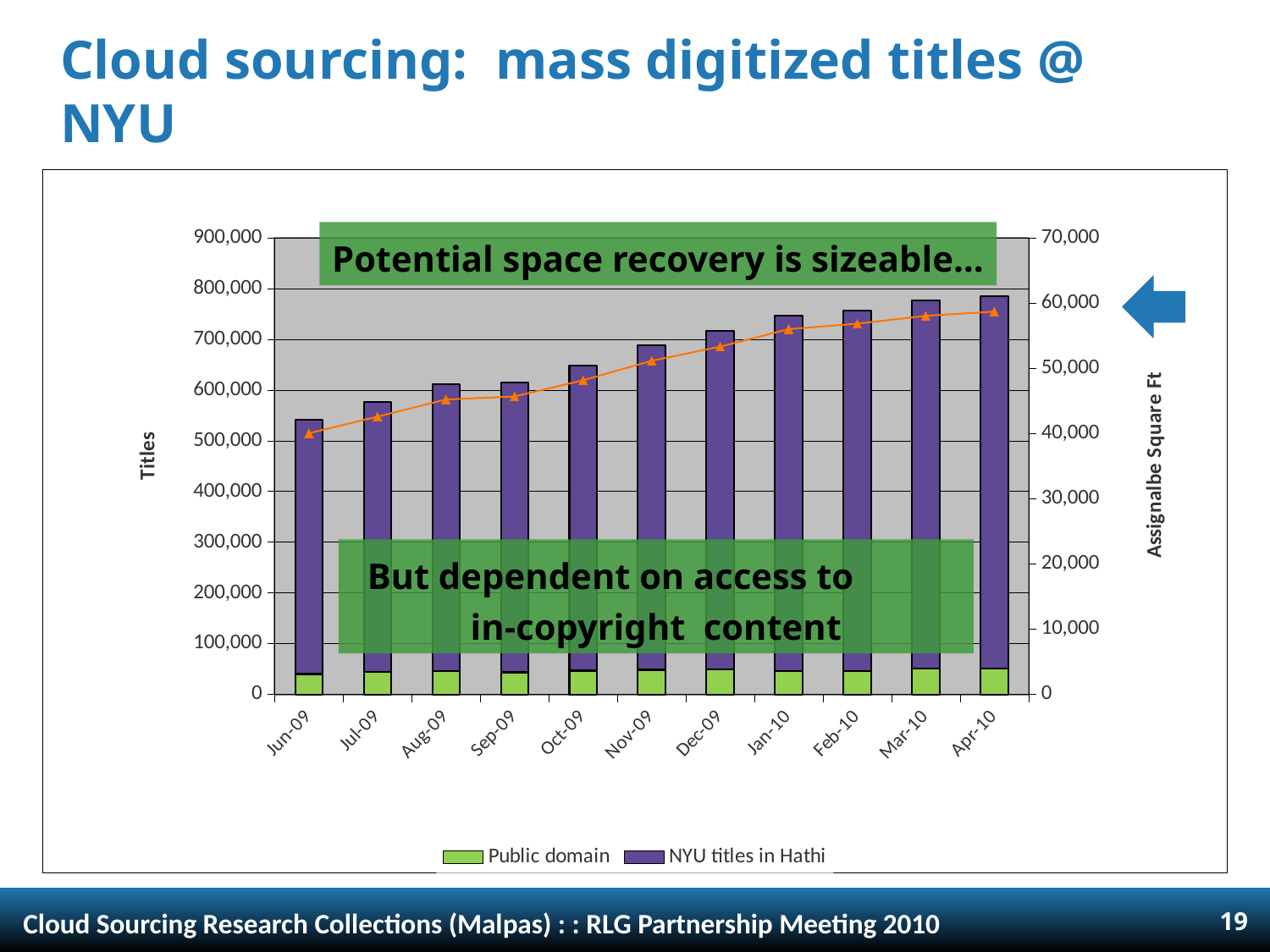
How many months are shown along the x axis of the chart? 11 Which series are listed in the chart's legend? Public domain and NYU titles in Hathi Is the total bar height for Jan-10 greater or less than 700,000 titles? greater How many series does the chart's legend list? 2 Which month has the shortest stacked bar? Jun-09 Is the total bar height for Apr-10 greater or less than 800,000 titles? less What kind of chart is shown on the slide? bar chart (stacked bars with a line) Do the stacked bar totals rise or fall from Jun-09 to Apr-10? rise Is the total bar height for Jun-09 greater or less than 500,000 titles? greater What is the title of the left vertical axis? Titles Which month has the tallest stacked bar? Apr-10